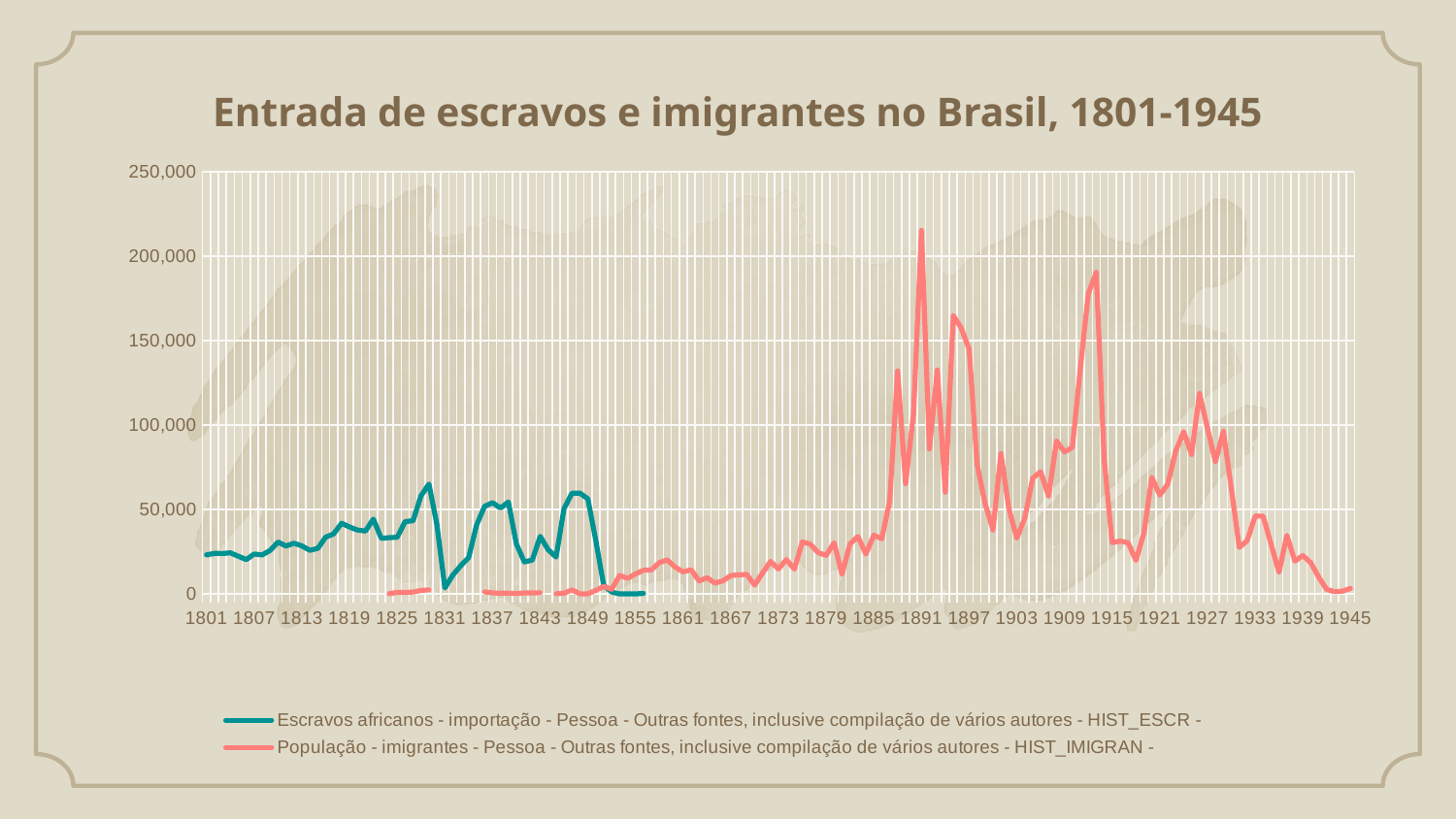
Which series reaches a higher maximum value, 'Escravos africanos - importação' or 'População - imigrantes'? População - imigrantes What is the title of the chart? Entrada de escravos e imigrantes no Brasil, 1801-1945 What kind of chart is shown on the slide? Line chart How many year labels are shown on the x axis? 25 Is the value of the 'População - imigrantes' series in 1945 greater or less than 50,000? less Which colour is used for the 'Escravos africanos - importação' series? Teal (green) Does the 'População - imigrantes' series rise or fall between 1927 and 1945? Fall Is the value of the 'Escravos africanos - importação' series in 1801 greater or less than 50,000? less How many series does the legend list? 2 What is the highest value shown on the y axis? 250,000 Is the peak value of the 'População - imigrantes' series around 1891 greater or less than 200,000? greater